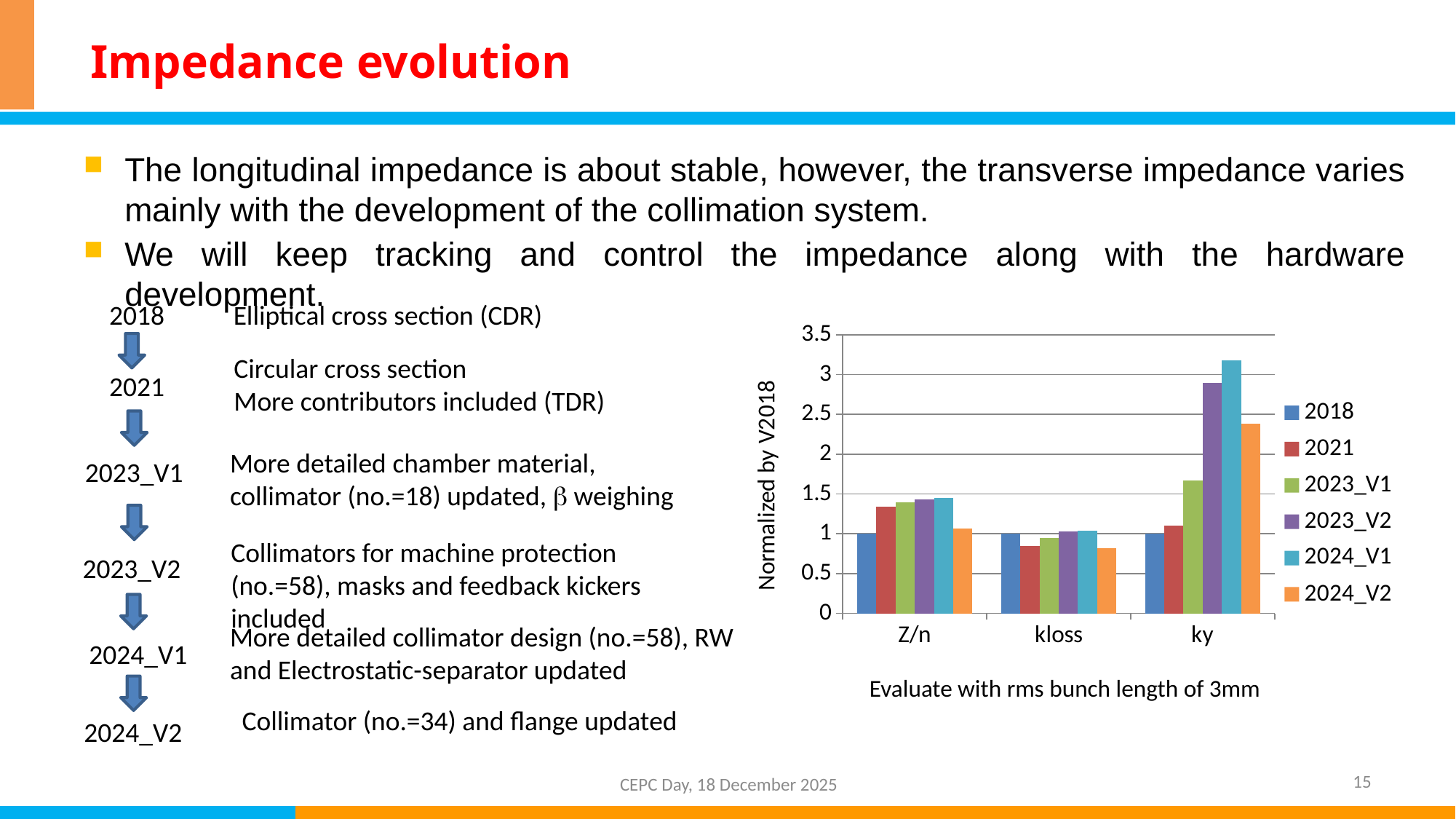
How many categories are shown on the x axis of the chart? 3 Which category contains the tallest bar in the chart? ky Which series has the highest bar for ky? 2024_V1 Is the value for 2024_V1 at ky greater or less than 3? greater Is the value for 2023_V1 at ky greater or less than 1.5? greater For ky, which is larger: the 2024_V1 bar or the 2024_V2 bar? 2024_V1 What is the value of the 2018 series for Z/n? 1 For Z/n, which is larger: the 2021 bar or the 2024_V2 bar? 2021 What kind of chart is shown on the slide? bar chart Is the value for 2024_V2 at kloss greater or less than 1? less What is the label of the chart's vertical axis? Normalized by V2018 How many series does the chart legend list? 6